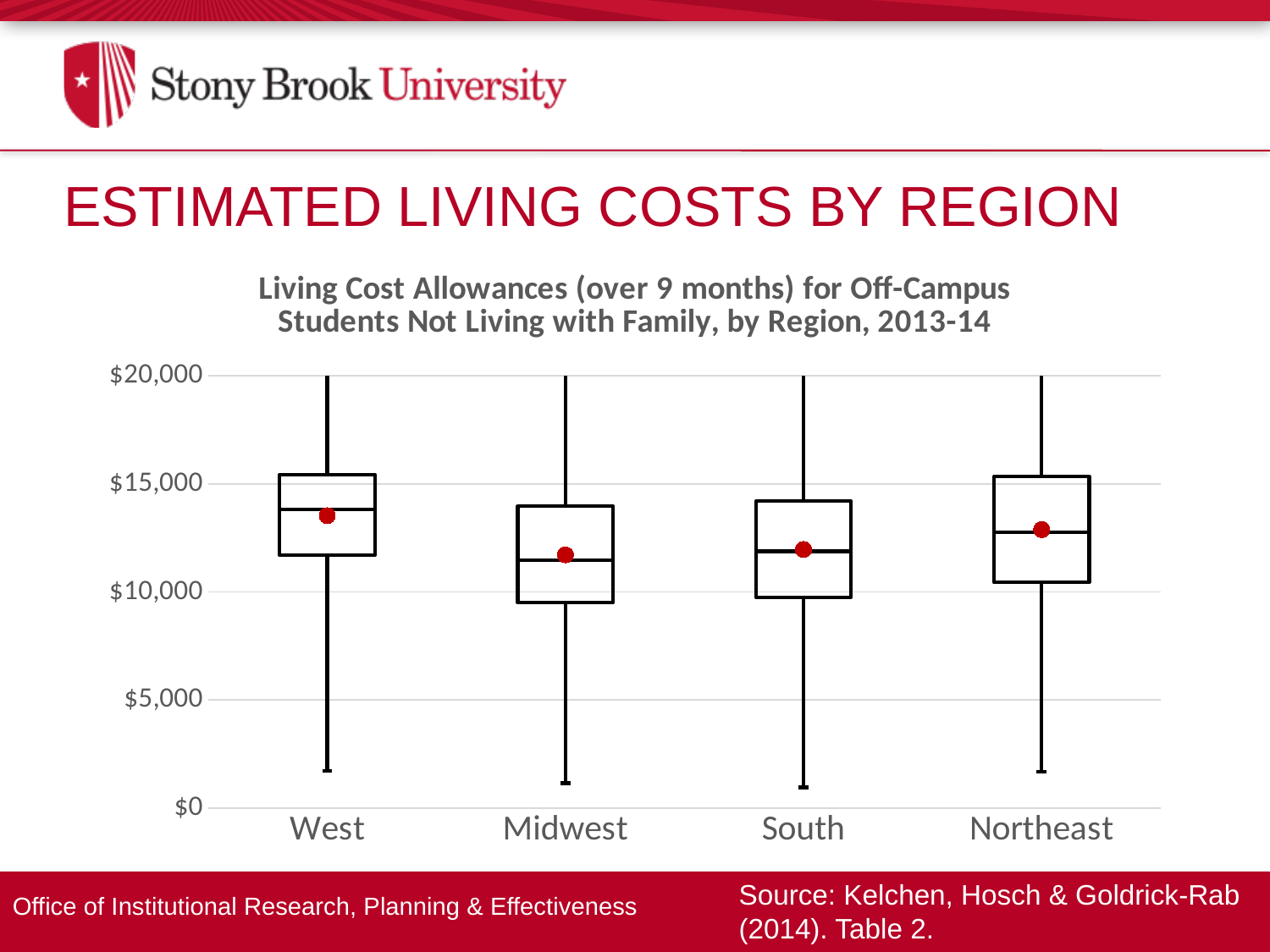
Is the median line for West greater or less than $10,000? greater Which has a higher red dot, Northeast or South? Northeast Which region has the highest median line? West Is the median line for Midwest greater or less than $15,000? less Is the top of the box for Northeast greater or less than $20,000? less How many regions are shown on the x axis of the chart? 4 What is the title of the chart? Living Cost Allowances (over 9 months) for Off-Campus Students Not Living with Family, by Region, 2013-14 Which has a higher median line, West or Midwest? West What kind of chart is shown on the slide? Box plot Which region has the highest red dot? West